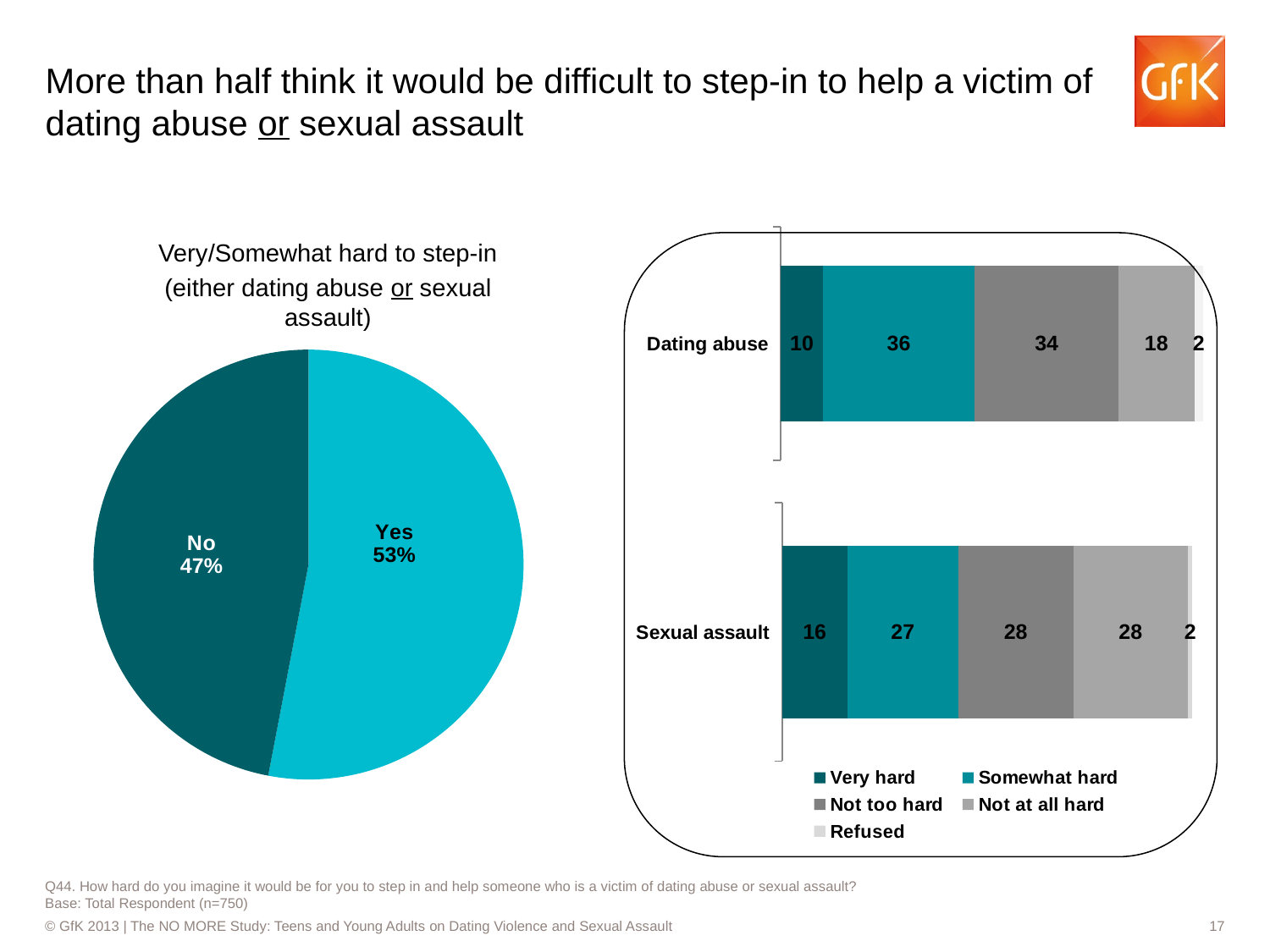
What kind of chart is the chart on the left of the slide? Pie chart What kind of chart is the chart on the right of the slide? Stacked bar chart How many series does the legend of the stacked bar chart on the right list? 5 In the stacked bar chart on the right, what is the value for Not at all hard for Dating abuse? 18 In the stacked bar chart on the right, what is the difference between the Very hard values for Sexual assault and Dating abuse? 6 In the pie chart on the left, which slice is larger, Yes or No? Yes In the stacked bar chart on the right, what is the value for Somewhat hard for Dating abuse? 36 In the stacked bar chart on the right, what is the total of the Very hard and Somewhat hard values for Sexual assault? 43 In the stacked bar chart on the right, which category has the higher Somewhat hard value, Dating abuse or Sexual assault? Dating abuse In the pie chart on the left, what share of respondents answered No? 47% In the stacked bar chart on the right, what is the value for Very hard for Sexual assault? 16 In the pie chart on the left, what share of respondents answered Yes? 53%